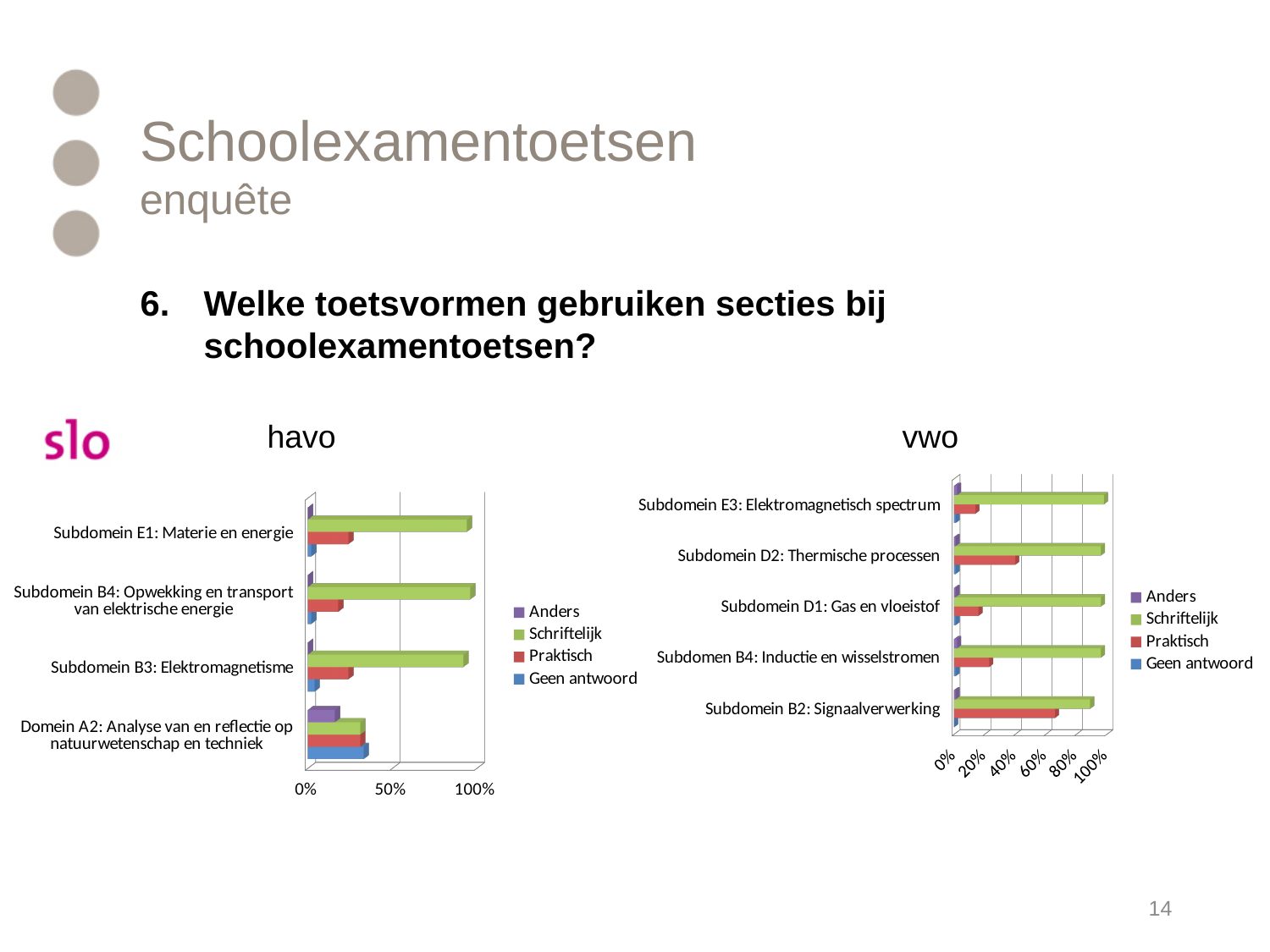
In the havo chart, which is larger for Subdomein E1: Materie en energie, Schriftelijk or Praktisch? Schriftelijk How many categories are shown on the havo chart? 4 In the havo chart, is the Schriftelijk value for Domein A2: Analyse van en reflectie op natuurwetenschap en techniek greater or less than 50%? less In the vwo chart, is the Schriftelijk value for Subdomein E3: Elektromagnetisch spectrum greater or less than 80%? greater How many series does the legend of the vwo chart list? 4 In the havo chart, which category has the lowest Schriftelijk value? Domein A2: Analyse van en reflectie op natuurwetenschap en techniek In the havo chart, is the Schriftelijk value for Subdomein E1: Materie en energie greater or less than 50%? greater What kind of chart is the havo chart? bar chart Which series is shown in green in the vwo chart's legend? Schriftelijk How many categories are shown on the vwo chart? 5 In the vwo chart, which category has the highest Praktisch value? Subdomein B2: Signaalverwerking